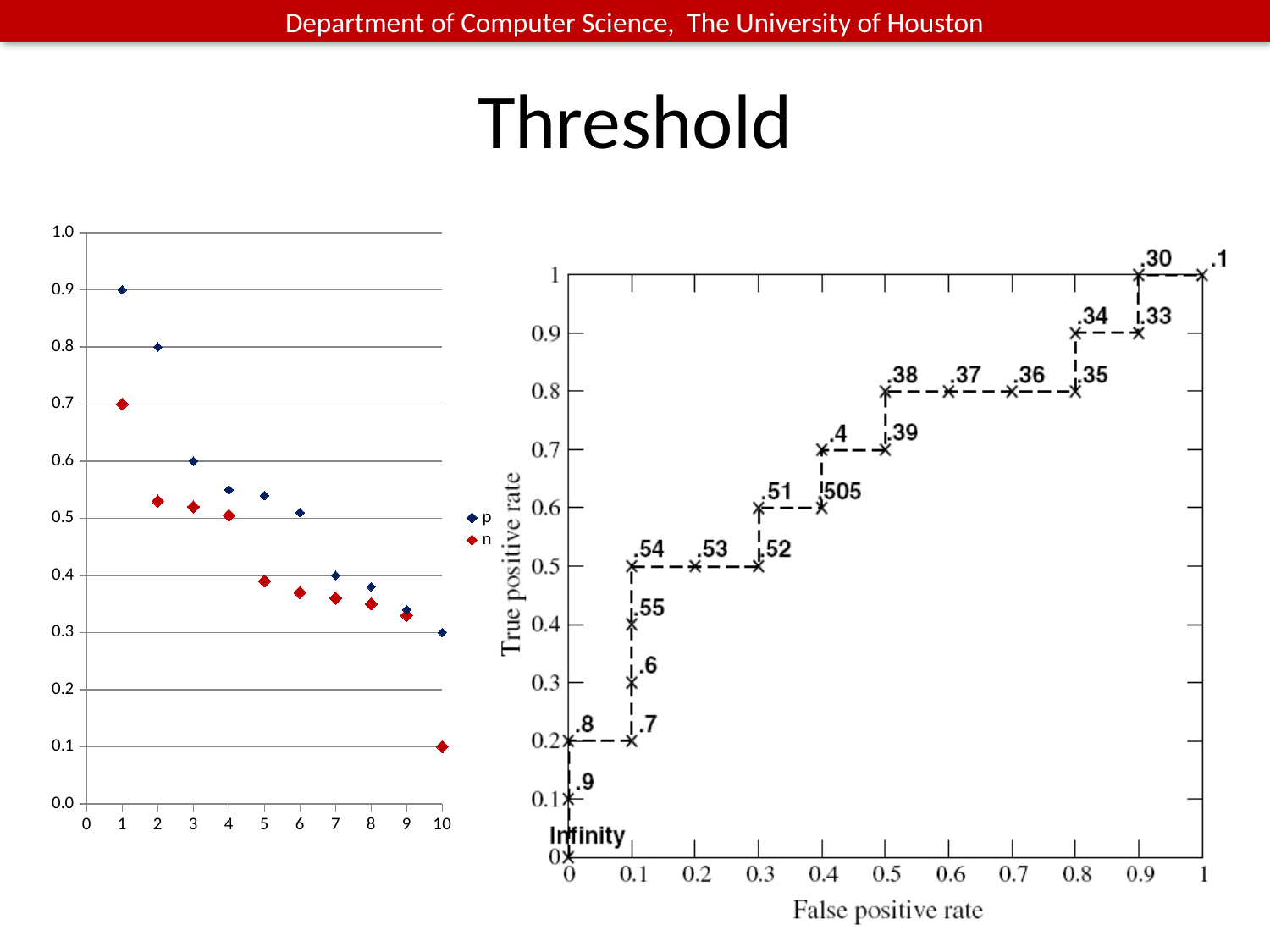
In the left chart, what is the value of series p at x = 10? 0.3 In the left chart, what is the value of series p at x = 1? 0.9 In the left chart, is the value of series n at x = 5 greater or less than 0.5? less How many series does the legend of the left chart list? 2 In the right chart, what is the label of the x axis? False positive rate In the left chart, do the values of series p rise or fall as x increases from 1 to 10? fall In the left chart, what is the value of series n at x = 10? 0.1 In the right chart (True positive rate vs False positive rate), what is the true positive rate at the point labelled .54? 0.5 In the right chart (True positive rate vs False positive rate), what is the false positive rate at the point labelled .38? 0.5 In the left chart, how many points are plotted for series p? 10 What kind of chart is the left chart on the slide? scatter chart In the left chart, which series has the larger value at x = 1, p or n? p